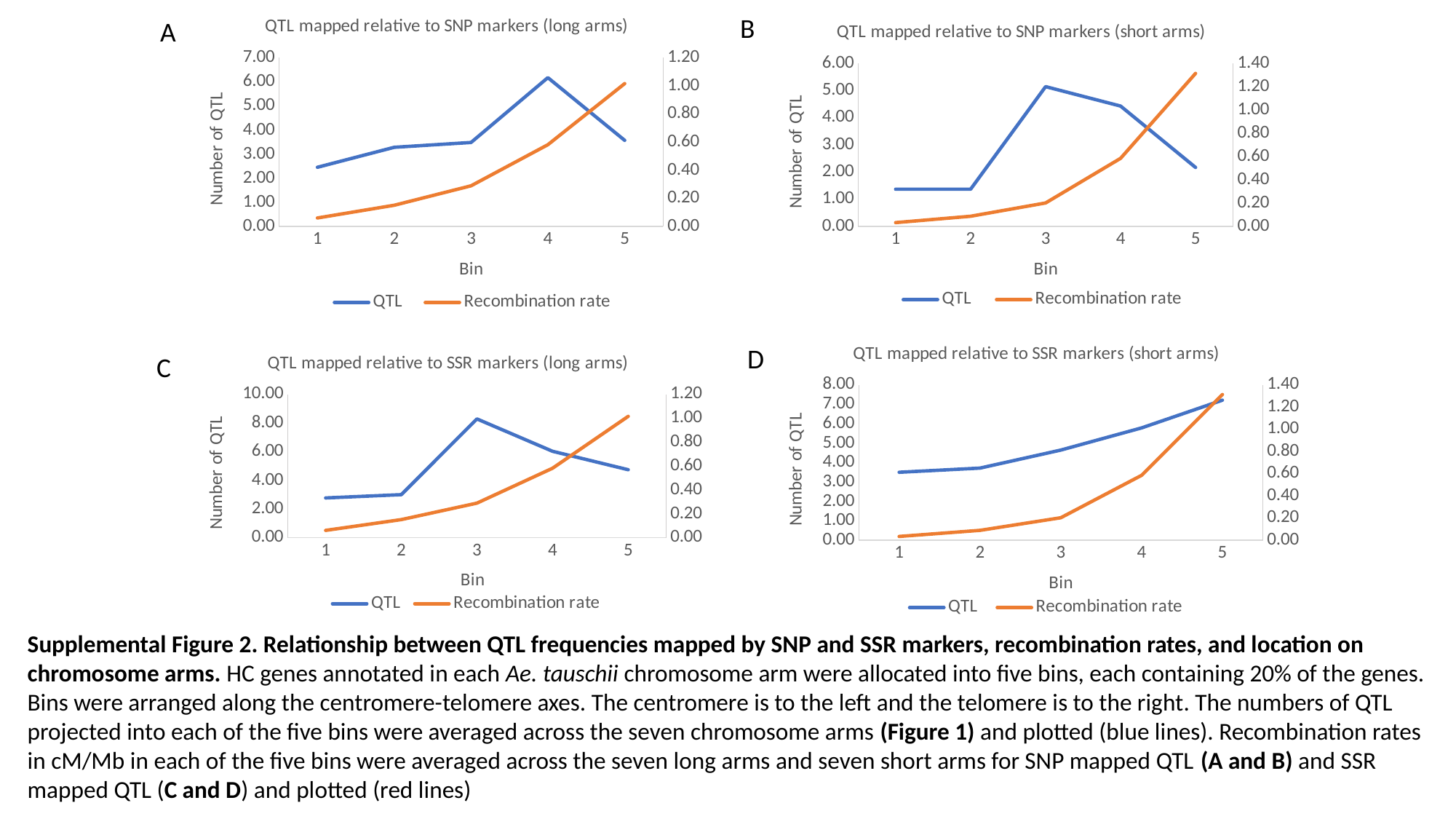
In chart D, "QTL mapped relative to SSR markers (short arms)", does the QTL line rise or fall from bin 1 to bin 5? rise In chart A, "QTL mapped relative to SNP markers (long arms)", at which bin is the QTL line highest? 4 In chart C, "QTL mapped relative to SSR markers (long arms)", is the QTL value at bin 3 greater or less than 6.00? greater What kind of chart is chart A, "QTL mapped relative to SNP markers (long arms)"? Line chart How many bins are plotted along the x axis of chart C, "QTL mapped relative to SSR markers (long arms)"? 5 In chart A, "QTL mapped relative to SNP markers (long arms)", is the QTL value at bin 4 greater or less than 5.00? greater How many series does the legend of chart B, "QTL mapped relative to SNP markers (short arms)", list? 2 In chart D, "QTL mapped relative to SSR markers (short arms)", which bin has the higher QTL value, bin 1 or bin 5? 5 What is the x-axis title of chart D, "QTL mapped relative to SSR markers (short arms)"? Bin In chart B, "QTL mapped relative to SNP markers (short arms)", is the recombination rate at bin 5 greater or less than 1.00? greater In chart B, "QTL mapped relative to SNP markers (short arms)", at which bin is the QTL line highest? 3 In chart C, "QTL mapped relative to SSR markers (long arms)", at which bin is the QTL line lowest? 1